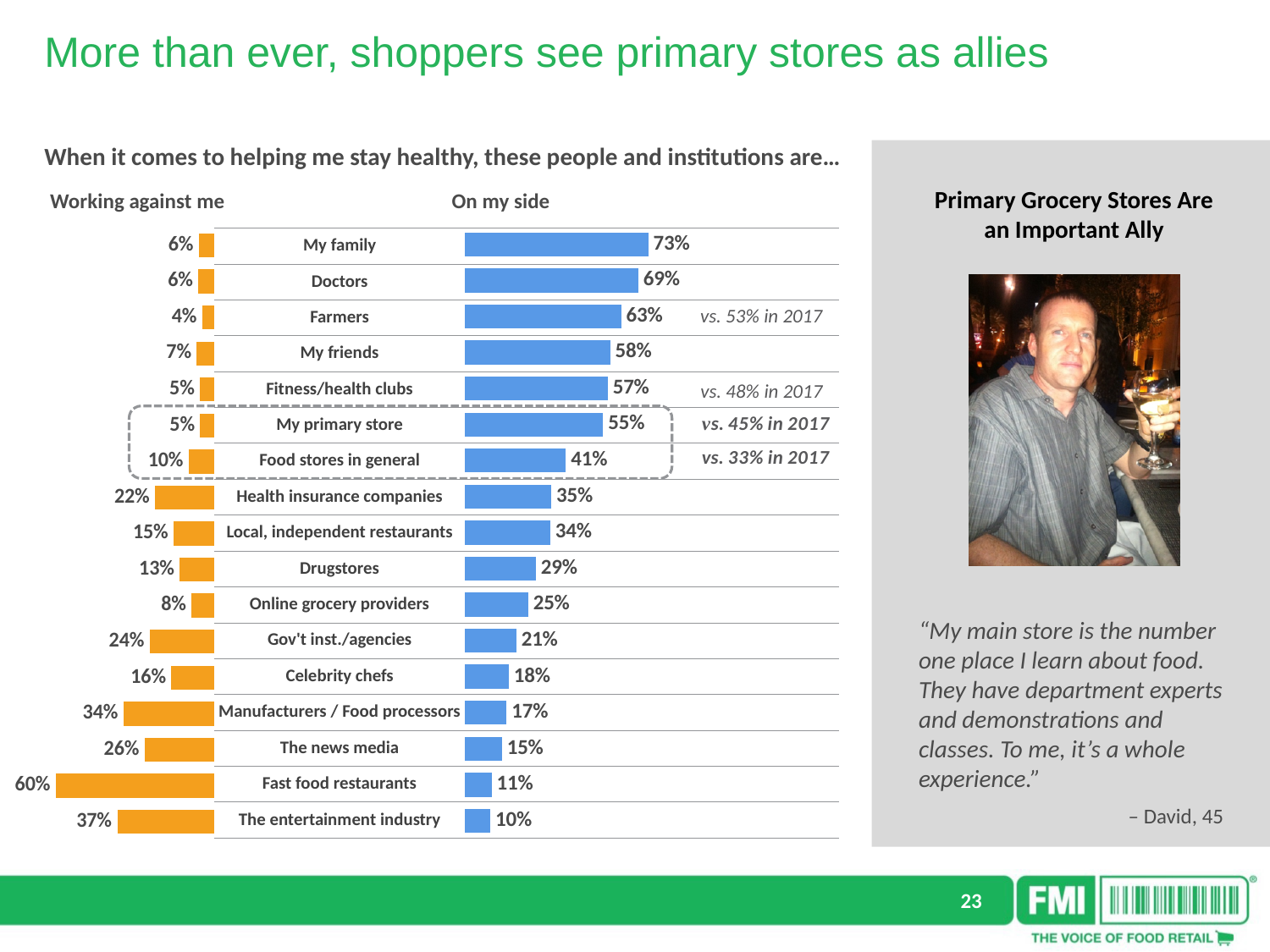
What is the difference between the "On my side" values for My family and Doctors? 4% How many series does the chart show? 2 What colour are the "Working against me" bars? Orange How many categories are shown in the chart? 17 What kind of chart is shown on the slide? Bar chart What was the "On my side" value for Food stores in general in 2017, according to the annotation? 33% What percentage of shoppers say fast food restaurants are "Working against me"? 60% Which category has the highest "On my side" value? My family Which has a higher "On my side" value, Farmers or My friends? Farmers Which category has the highest "Working against me" value? Fast food restaurants Which category has the lowest "On my side" value? The entertainment industry What percentage of shoppers say their primary store is "On my side"? 55%